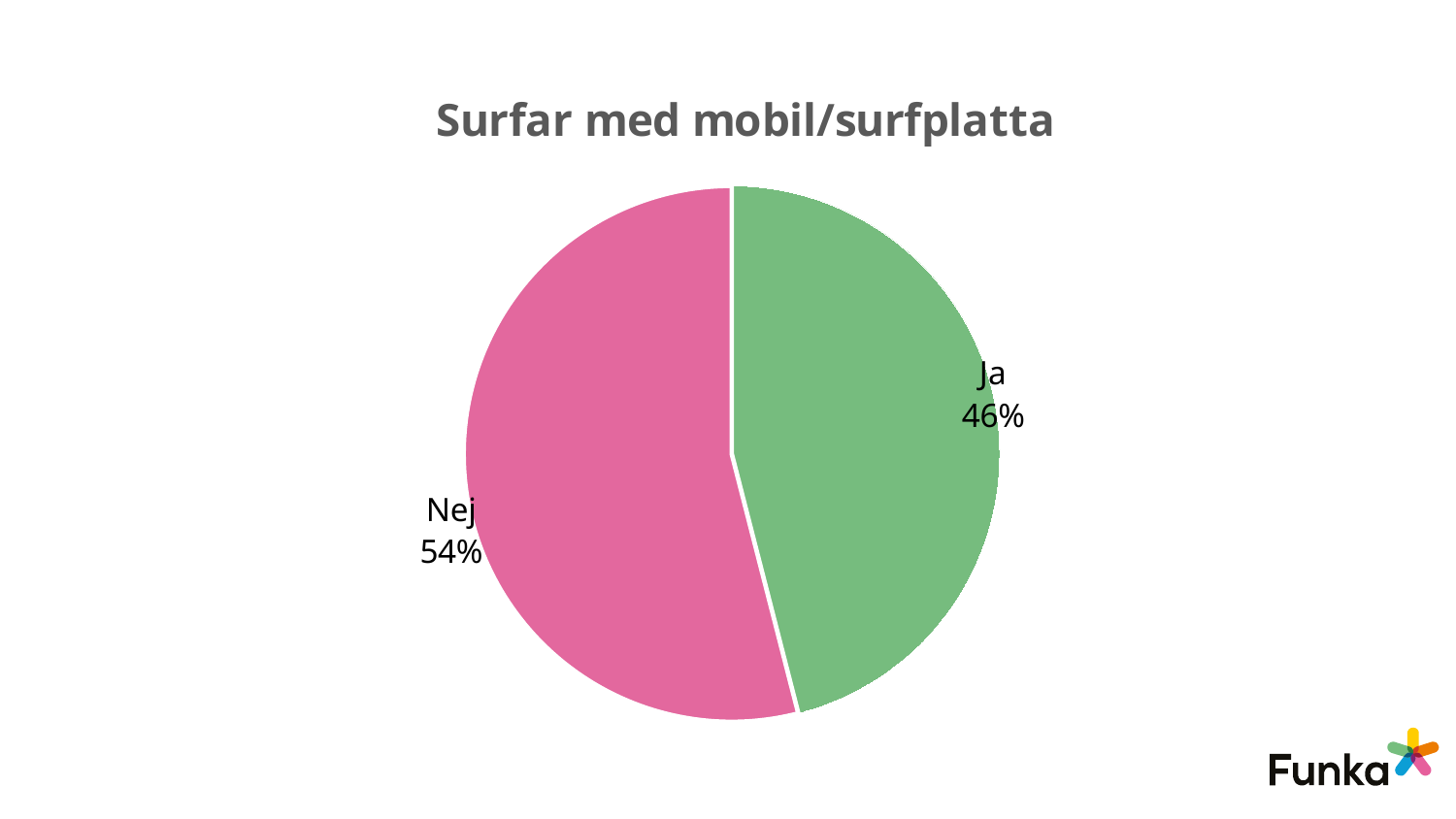
Is the value for "Ja" greater or less than 50%? less Is the value for "Nej" greater or less than 50%? greater Which slice is the largest? Nej Which is larger, the "Ja" slice or the "Nej" slice? Nej Which slice is the smallest? Ja What share of the pie is labelled "Nej"? 54% How many slices does the pie chart have? 2 What is the difference in percentage points between the "Nej" and "Ja" slices? 8 What share of the pie is labelled "Ja"? 46% What is the title of the chart? Surfar med mobil/surfplatta What colour is the "Ja" slice? green What kind of chart is shown on the slide? pie chart